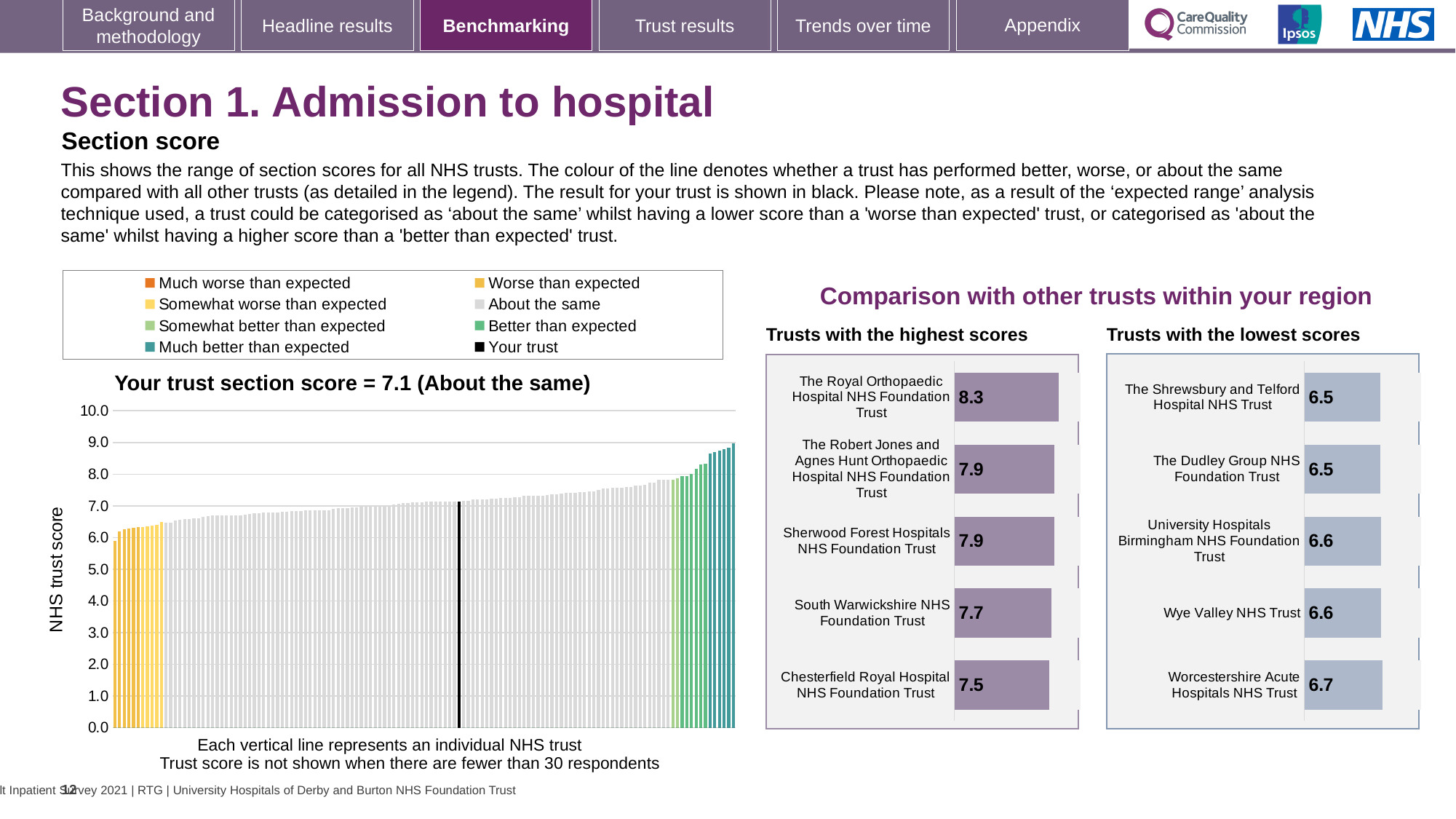
In the 'Your trust section score' chart, what is the section score for your trust? 7.1 In the 'Trusts with the lowest scores' chart, what is the score for Wye Valley NHS Trust? 6.6 In the 'Trusts with the lowest scores' chart, which trust has the highest score? Worcestershire Acute Hospitals NHS Trust In the 'Your trust section score' chart, do the trust scores rise or fall from left to right along the x axis? rise In the 'Your trust section score' chart, what category is your trust placed in? About the same In the 'Trusts with the highest scores' chart, which trust has the lowest score? Chesterfield Royal Hospital NHS Foundation Trust How many entries does the legend above the 'Your trust section score' chart list? 8 In the 'Trusts with the lowest scores' chart, which is larger: the score for Worcestershire Acute Hospitals NHS Trust or The Dudley Group NHS Foundation Trust? Worcestershire Acute Hospitals NHS Trust What kind of chart is the 'Your trust section score' chart? bar chart In the 'Trusts with the highest scores' chart, what is the difference between the scores of The Royal Orthopaedic Hospital NHS Foundation Trust and Chesterfield Royal Hospital NHS Foundation Trust? 0.8 How many trusts are shown in the 'Trusts with the highest scores' chart? 5 In the 'Trusts with the highest scores' chart, what is the score for The Royal Orthopaedic Hospital NHS Foundation Trust? 8.3